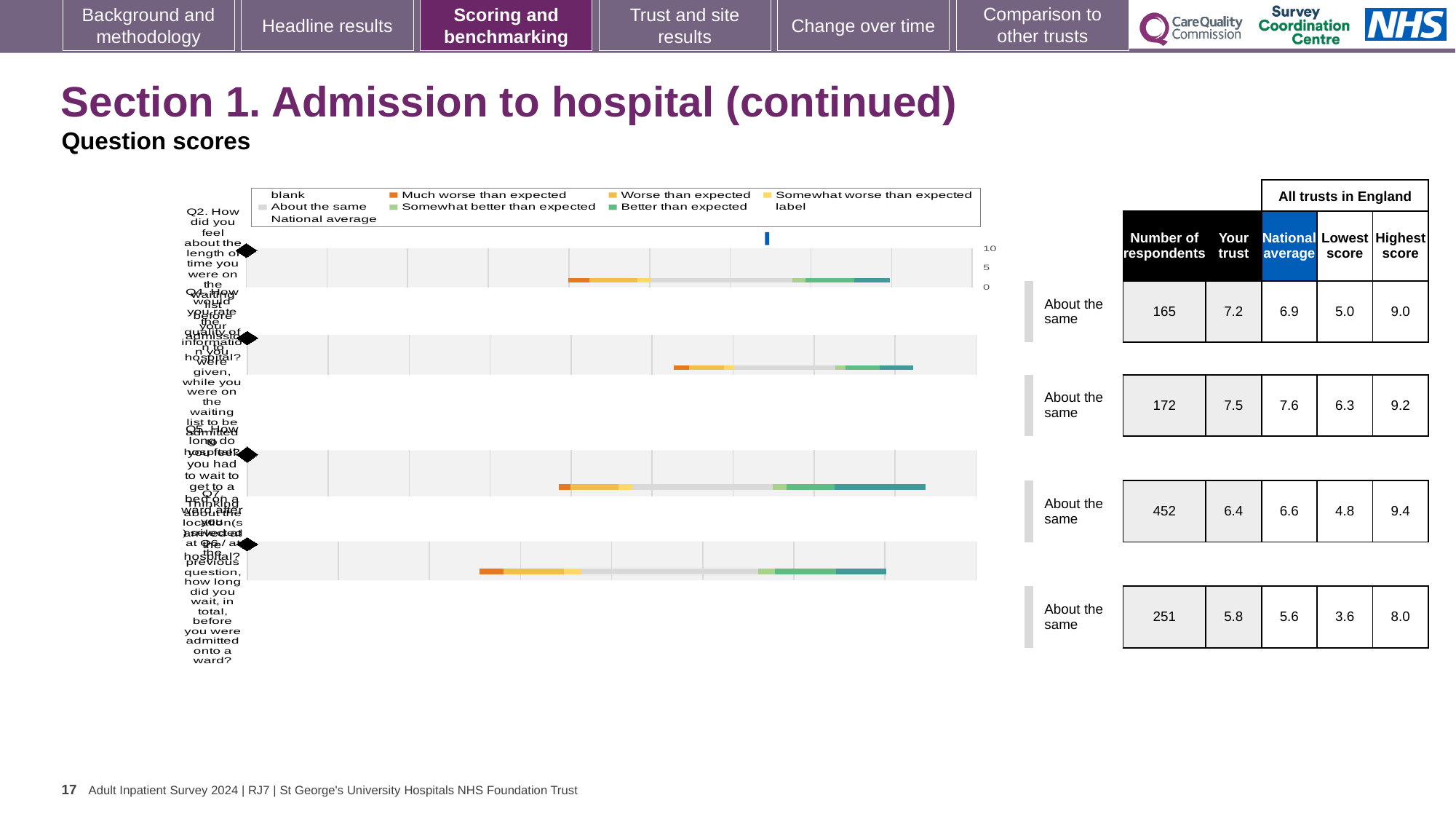
What is the smallest 'Your trust' score shown in the table? 5.8 What colour in the legend represents 'Much worse than expected'? orange Which row of the table has the highest number of respondents? the third row (452) What benchmark category label is shown beside every question in the chart? About the same In the table, how many respondents are in the row where 'Your trust' scores 6.4? 452 In the second row of the table (172 respondents), which is larger: 'Your trust' or 'National average'? National average What is the difference between the highest score and the lowest score in the first row of the table? 4.0 In the table, what is the 'Your trust' score for the first row (165 respondents)? 7.2 In the table, what is the lowest score for the fourth row (251 respondents)? 3.6 What kind of chart is shown on the slide? bar chart What is the largest 'Highest score' value shown in the table? 9.4 How many question rows (bars) are plotted in the chart? 4